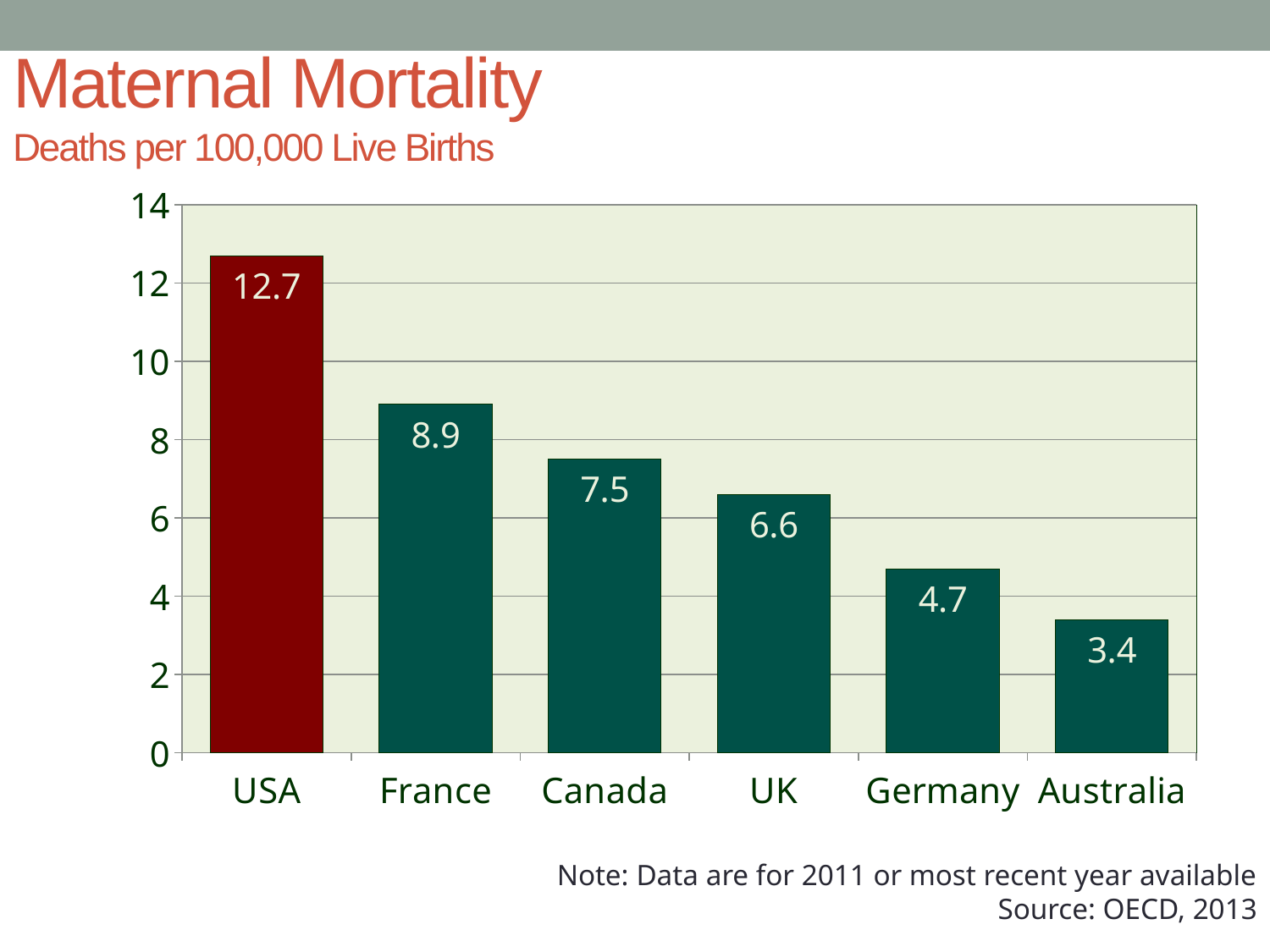
What is the maternal mortality value for the USA? 12.7 Is the value for the UK greater or less than 8? less Which country has the lowest maternal mortality rate on the chart? Australia Which has a higher value, France or Canada? France What is the value shown for Germany? 4.7 Which country has the highest maternal mortality rate on the chart? USA What kind of chart is shown on the slide? bar chart What is the difference between the values for the UK and Australia? 3.2 How many countries are shown on the chart? 6 What is the value shown for Canada? 7.5 What is the difference between the values for the USA and France? 3.8 Which bar is coloured differently from the others? USA